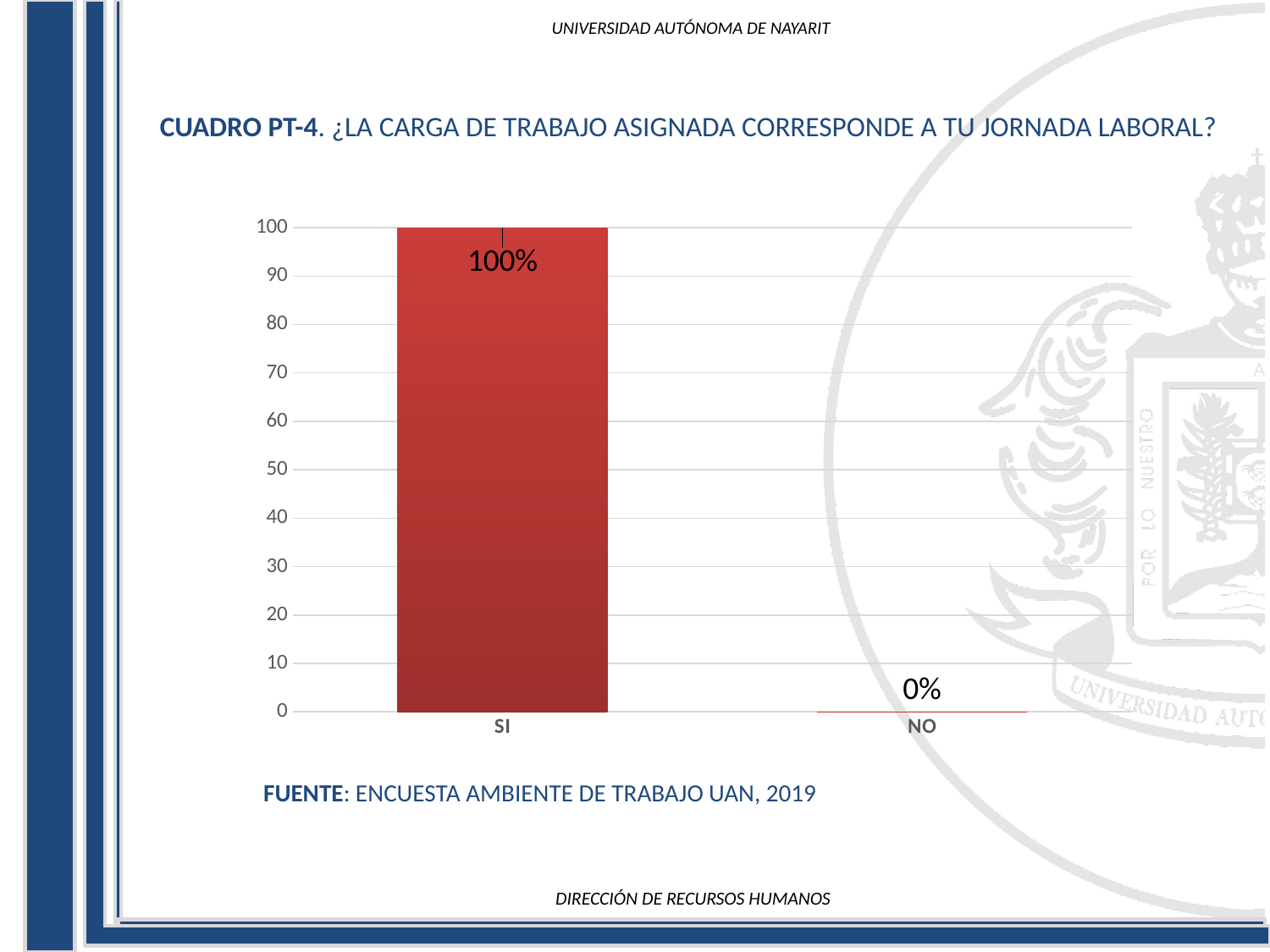
Which category has the highest value? SI What is the value for NO? 0% How many categories are shown on the x axis? 2 What is the source cited below the chart? ENCUESTA AMBIENTE DE TRABAJO UAN, 2019 Which category has the lowest value? NO What kind of chart is shown on the slide? bar chart Do the values rise or fall from SI to NO? fall Which is larger, the value for SI or the value for NO? SI What is the highest tick value shown on the y axis? 100 What is the value for SI? 100% Is the value for SI greater or less than 50? greater What is the difference between the values for SI and NO? 100%